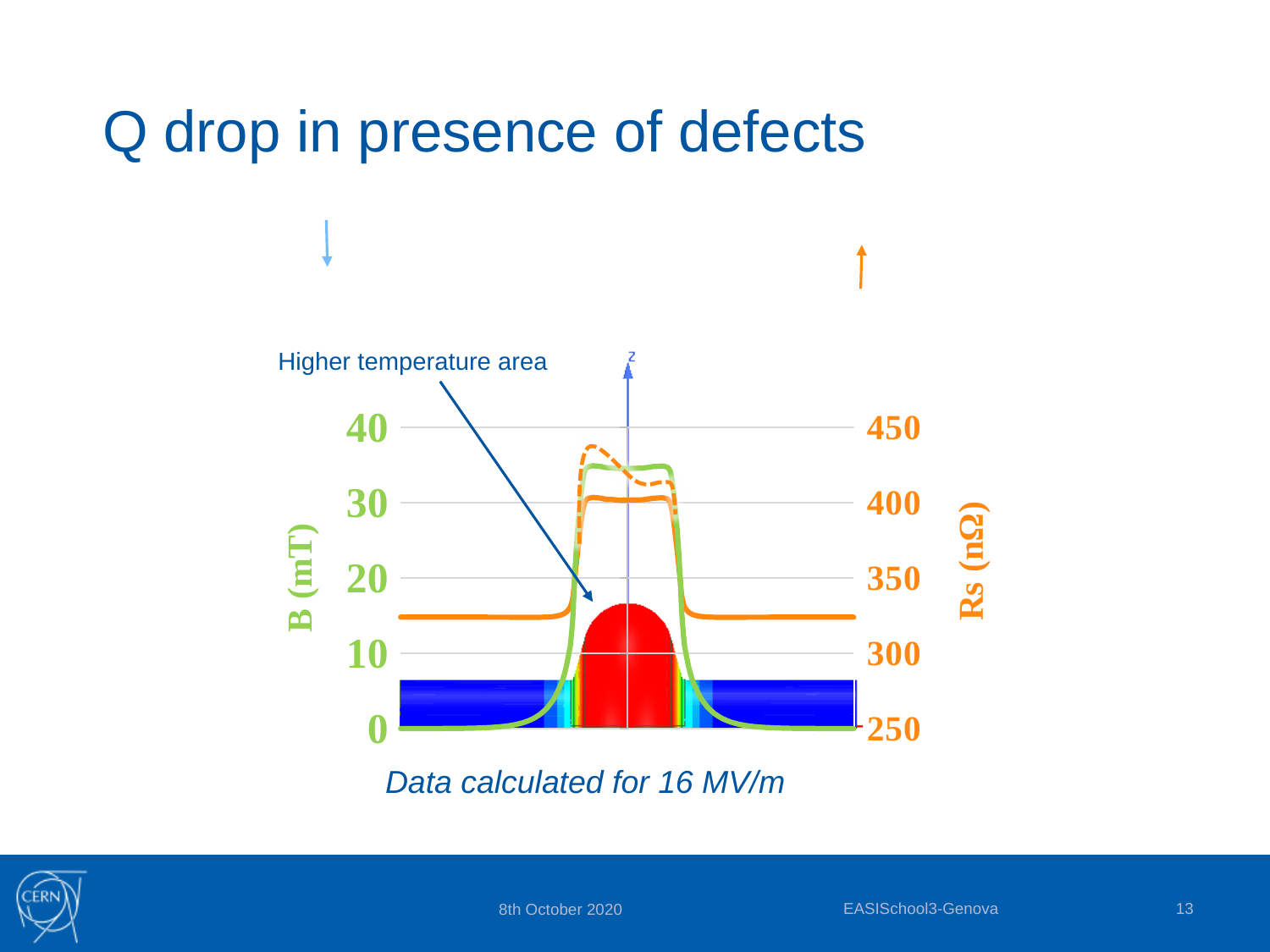
According to the caption under the chart, for what accelerating gradient was the data calculated? 16 MV/m What is the highest tick value shown on the left vertical axis (B)? 40 Away from the defect, is the flat level of the solid orange Rs curve greater or less than 300 nΩ? greater What kind of chart is shown on the slide? line chart Far from the defect, is the solid green B curve greater or less than 10 mT? less What is the label of the left vertical axis of the chart? B (mT) What is the label of the right vertical axis of the chart? Rs (nΩ) Away from the defect, is the flat level of the solid orange Rs curve greater or less than 350 nΩ? less What is the highest tick value shown on the right vertical axis (Rs)? 450 What is the lowest tick value shown on the right vertical axis (Rs)? 250